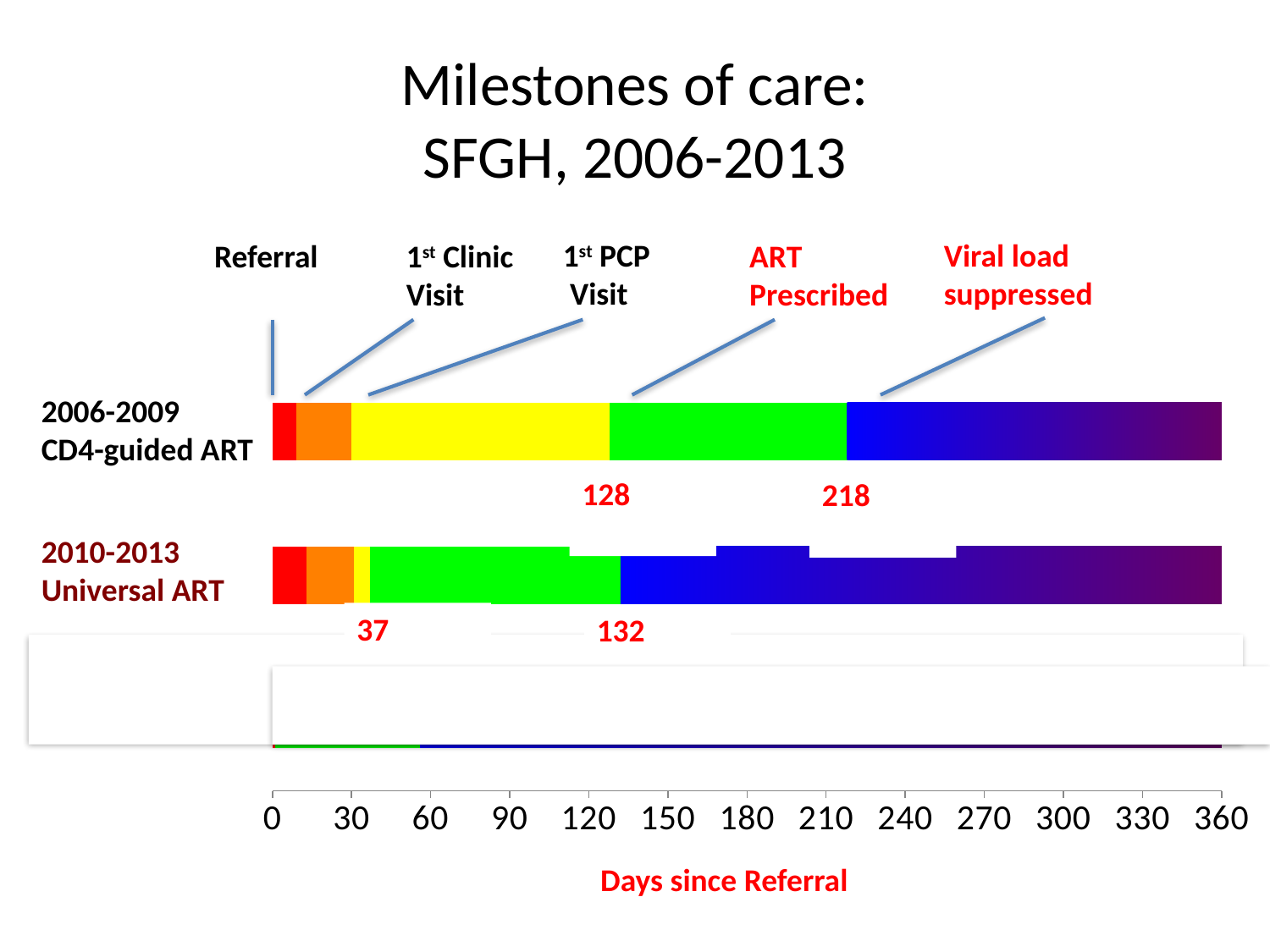
How many days after referral was viral load suppressed in the 2006-2009 CD4-guided ART period? 218 What is the title of the x axis? Days since Referral What is the difference in days to viral load suppression between the 2006-2009 and 2010-2013 periods? 86 Is the number of days to viral load suppression in the 2006-2009 period greater or less than 210? greater How many days after referral was ART prescribed in the 2006-2009 CD4-guided ART period? 128 How many days after referral was viral load suppressed in the 2010-2013 Universal ART period? 132 What kind of chart is shown on the slide? Bar chart Which period reached ART prescription sooner after referral, 2006-2009 or 2010-2013? 2010-2013 How many time periods (bars) are compared in the chart? 2 How many fewer days did it take to prescribe ART in 2010-2013 compared with 2006-2009? 91 How many days after referral was ART prescribed in the 2010-2013 Universal ART period? 37 In the 2006-2009 period, how many days elapsed between ART being prescribed and viral load suppression? 90